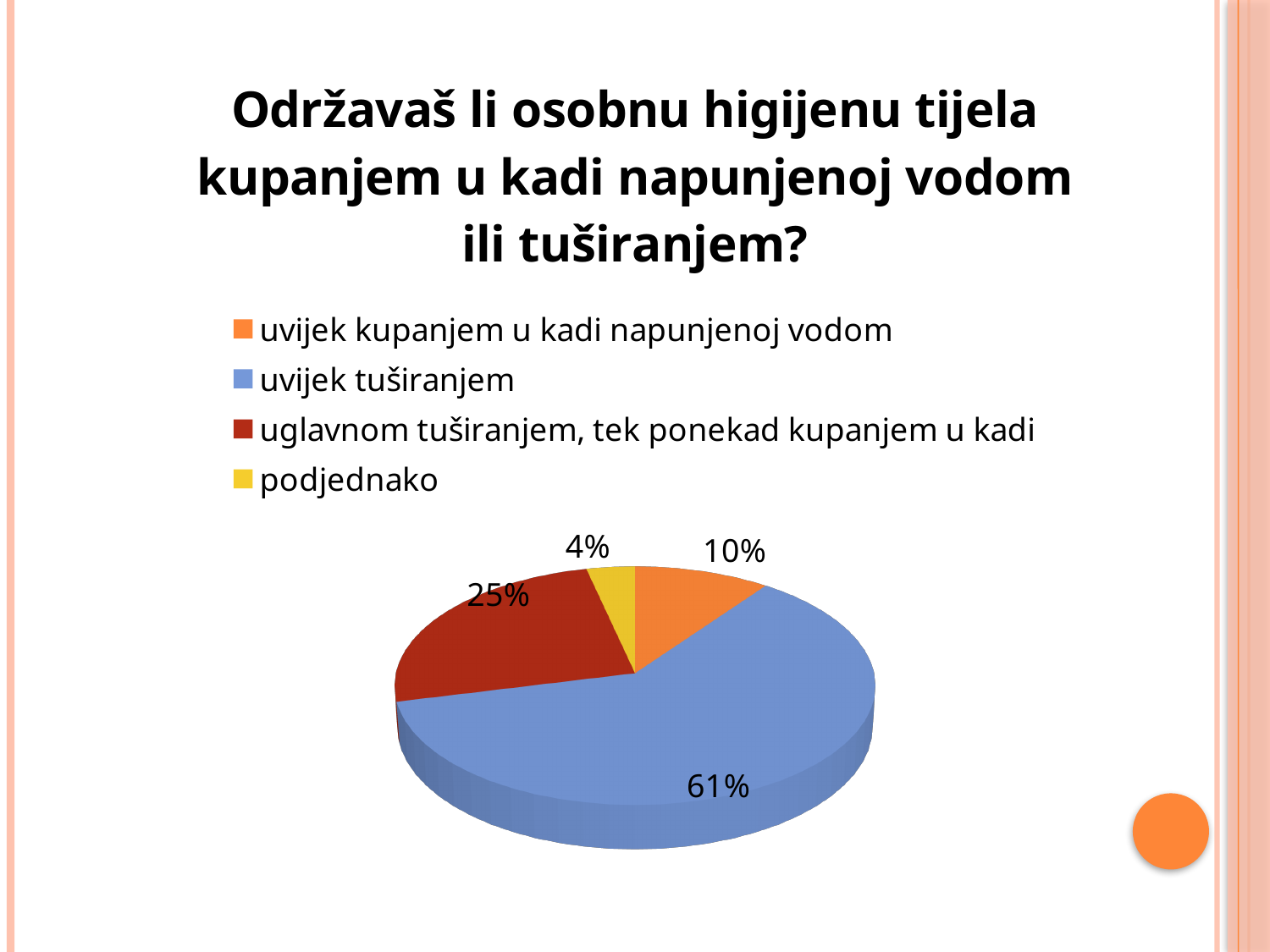
Which answer has the smallest share of the pie? podjednako What percentage of respondents answered "uglavnom tuširanjem, tek ponekad kupanjem u kadi"? 25% What is the difference in percentage points between "uvijek tuširanjem" and "uglavnom tuširanjem, tek ponekad kupanjem u kadi"? 36 What percentage of respondents answered "podjednako"? 4% What kind of chart is shown on the slide? pie chart What percentage of respondents answered "uvijek tuširanjem"? 61% What is the title of the chart? Održavaš li osobnu higijenu tijela kupanjem u kadi napunjenoj vodom ili tuširanjem? What colour is the slice for "uvijek tuširanjem"? blue What percentage of respondents answered "uvijek kupanjem u kadi napunjenoj vodom"? 10% Which is larger: the share for "uvijek kupanjem u kadi napunjenoj vodom" or the share for "podjednako"? uvijek kupanjem u kadi napunjenoj vodom Which answer has the largest share of the pie? uvijek tuširanjem How many slices does the pie chart have? 4